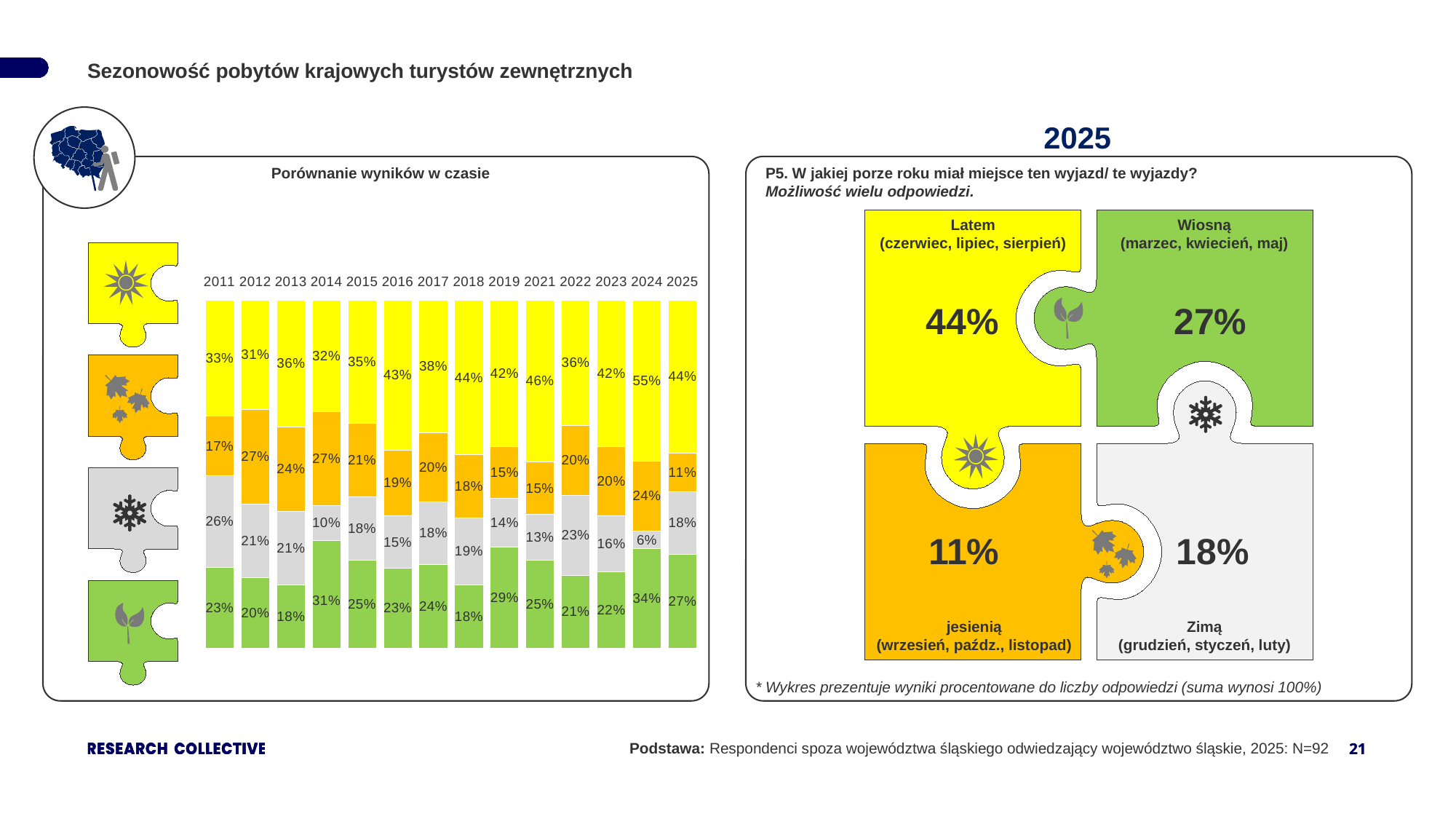
In the 2025 puzzle graphic on the right, what is the value for 'Wiosną (marzec, kwiecień, maj)'? 27% In the chart 'Porównanie wyników w czasie', what is the value of the grey (winter) segment for 2011? 26% In the chart 'Porównanie wyników w czasie', what is the difference between the yellow (summer) values for 2024 and 2025? 11 percentage points How many years are shown in the chart 'Porównanie wyników w czasie'? 14 In the chart 'Porównanie wyników w czasie', what is the value of the yellow (summer) segment for 2024? 55% In the chart 'Porównanie wyników w czasie', which year has the highest yellow (summer) value? 2024 How many series (seasons) are stacked in each bar of the chart 'Porównanie wyników w czasie'? 4 In the chart 'Porównanie wyników w czasie', which year has the lowest grey (winter) value? 2024 What kind of chart is 'Porównanie wyników w czasie'? Stacked bar chart In the chart 'Porównanie wyników w czasie', what is the value of the orange (autumn) segment for 2012? 27% What is the title of the chart on the left side of the slide? Porównanie wyników w czasie In the chart 'Porównanie wyników w czasie', which year has the larger green (spring) value, 2013 or 2014? 2014